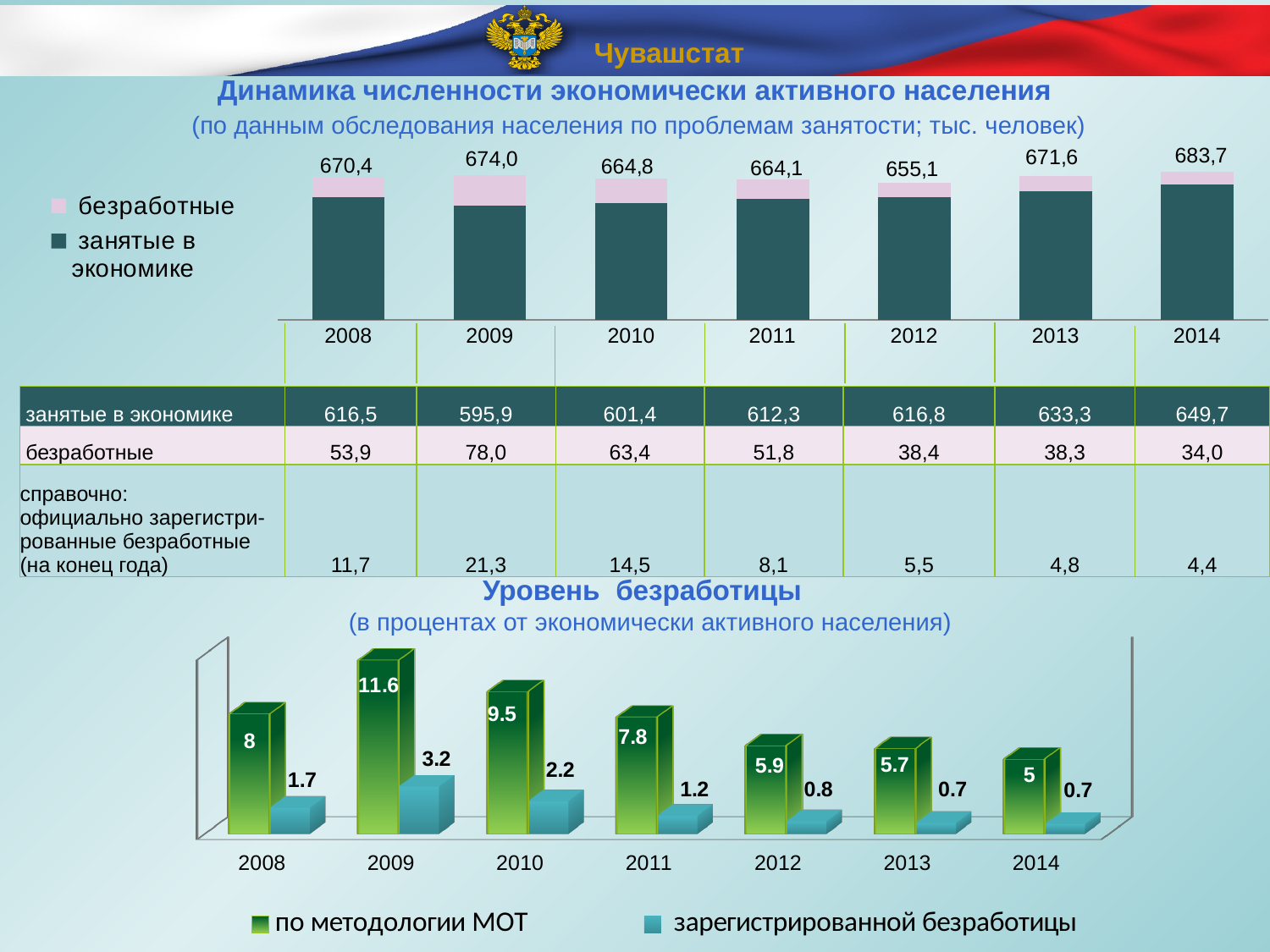
In the bottom chart 'Уровень безработицы', how many years are shown on the x axis? 7 In the bottom chart 'Уровень безработицы', what is the value 'по методологии МОТ' for 2009? 11.6 In the top chart 'Динамика численности экономически активного населения', which year has the lowest total economically active population? 2012 In the top chart 'Динамика численности экономически активного населения', how many series does the legend list? 2 In the top chart 'Динамика численности экономически активного населения', what is the total labelled above the bar for 2014? 683,7 In the top chart 'Динамика численности экономически активного населения', what is the difference between the 2014 total and the 2008 total? 13,3 In the bottom chart 'Уровень безработицы', does the 'по методологии МОТ' series rise or fall from 2009 to 2014? fall In the top chart 'Динамика численности экономически активного населения', which year has the highest total economically active population? 2014 In the bottom chart 'Уровень безработицы', which year has the highest unemployment rate 'по методологии МОТ'? 2009 What kind of chart is the bottom chart 'Уровень безработицы'? bar chart In the bottom chart 'Уровень безработицы', what is the difference between the 'по методологии МОТ' value and the 'зарегистрированной безработицы' value for 2012? 5.1 In the top chart 'Динамика численности экономически активного населения', what is the value of 'занятые в экономике' for 2009 according to the table under the chart? 595,9